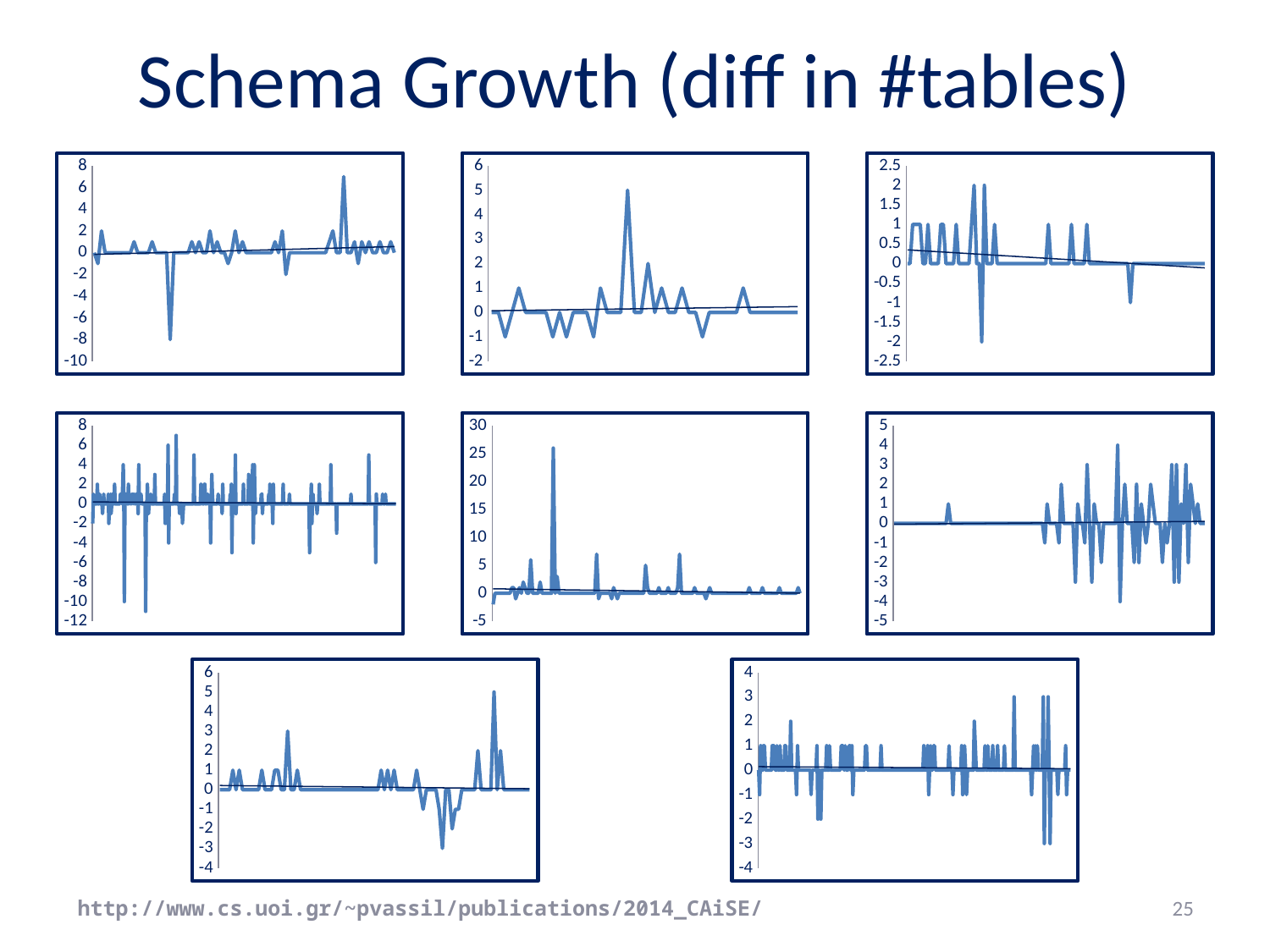
What is the title of the slide containing the charts? Schema Growth (diff in #tables) What is the highest tick value on the y axis of the middle-center chart? 30 In the middle-left chart, is the lowest value greater or less than -8? less In the middle-left chart, is the highest value greater or less than 4? greater In the middle-center chart, is the highest value greater or less than 20? greater How many charts are shown on the slide? 8 What kind of chart is the top-left chart on the slide? line chart In the top-right chart, does the straight trend line slope upward or downward from left to right? downward